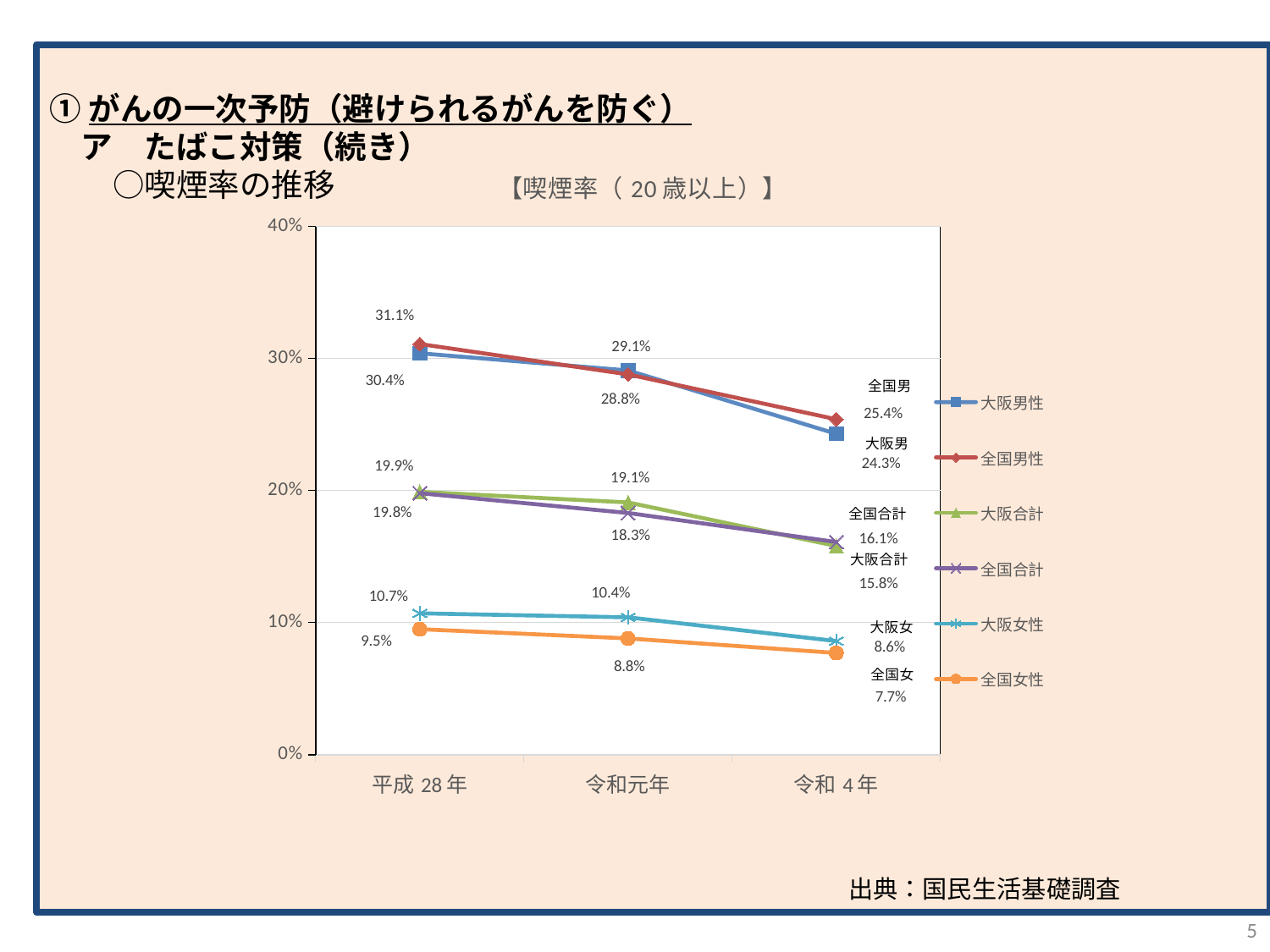
Which series has the lowest value in 令和4年? 全国女性 What kind of chart is shown on the slide? line chart What is the smoking rate for 大阪女性 in 平成28年? 10.7% What is the data source cited below the chart? 国民生活基礎調査 How many series does the legend list? 6 What is the smoking rate for 大阪女 in 令和4年? 8.6% In 令和4年, which is higher, 全国合計 or 大阪合計? 全国合計 What is the smoking rate for 大阪男 in 令和4年? 24.3% How many time points are shown on the x axis? 3 What is the smoking rate for 全国男 in 令和4年? 25.4% Does the smoking rate for 大阪男性 rise or fall from 平成28年 to 令和4年? fall What is the difference between 全国男 and 大阪男 in 令和4年? 1.1%